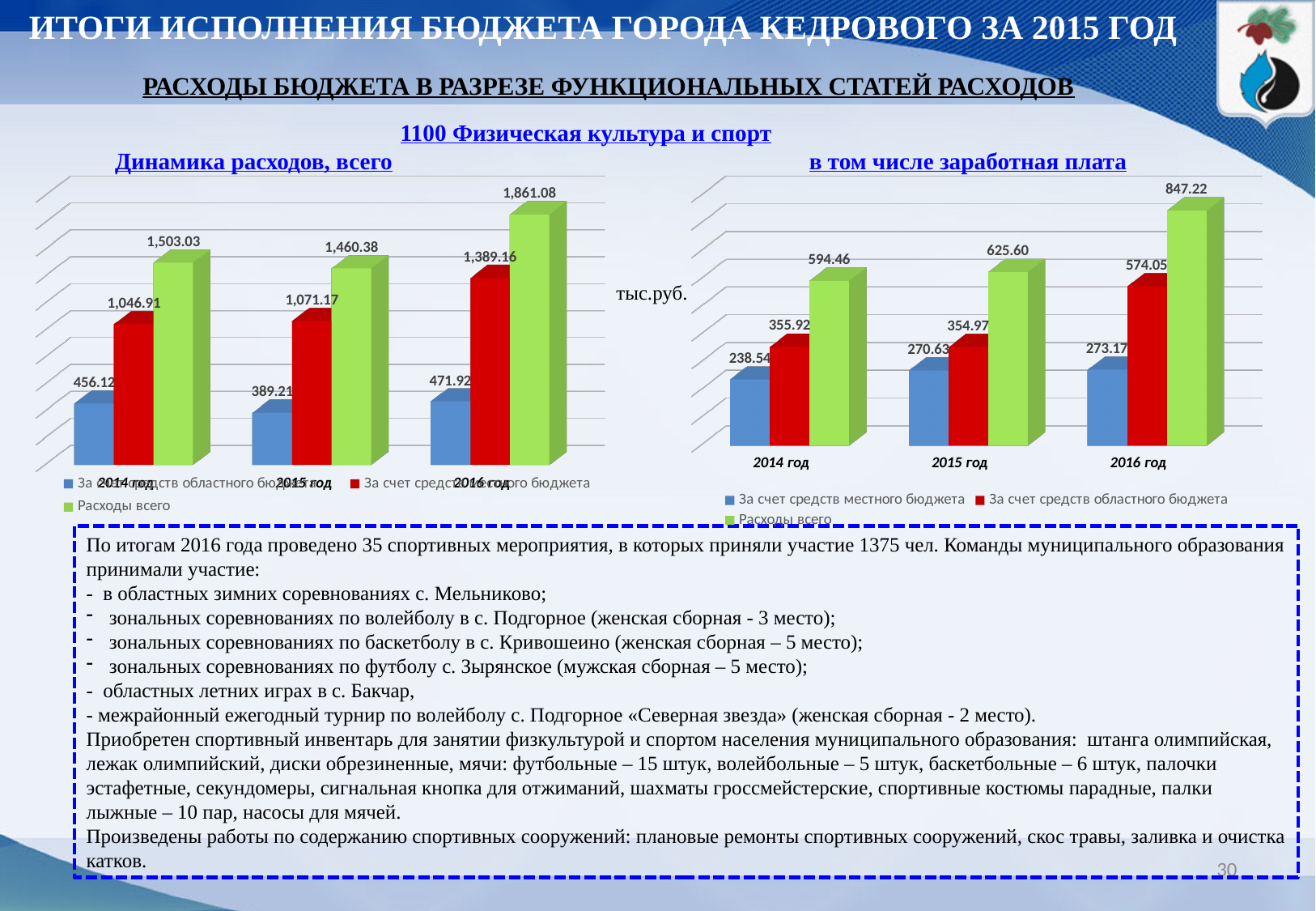
On the chart titled «Динамика расходов, всего», which year has the highest value of «Расходы всего»? 2016 год On the chart titled «Динамика расходов, всего», which is larger: «За счет средств областного бюджета» in 2014 год or in 2015 год? 2014 год On the chart titled «в том числе заработная плата», what is the value for «За счет средств местного бюджета» in 2016 год? 273.17 On the chart titled «Динамика расходов, всего», which year has the lowest value for «За счет средств местного бюджета»? 2014 год On the chart titled «в том числе заработная плата», does the value of «Расходы всего» rise or fall from 2014 год to 2016 год? Rise On the chart titled «Динамика расходов, всего», what is the value of «Расходы всего» for 2016 год? 1,861.08 On the chart titled «Динамика расходов, всего», what is the value for «За счет средств областного бюджета» in 2015 год? 389.21 On the chart titled «в том числе заработная плата», how many years are shown on the x axis? 3 On the chart titled «в том числе заработная плата», how many series does the legend list? 3 On the chart titled «в том числе заработная плата», what is the difference between «Расходы всего» in 2016 год and 2015 год? 221.62 On the chart titled «в том числе заработная плата», what is the value of «Расходы всего» for 2014 год? 594.46 What type of chart is «Динамика расходов, всего»? Bar chart